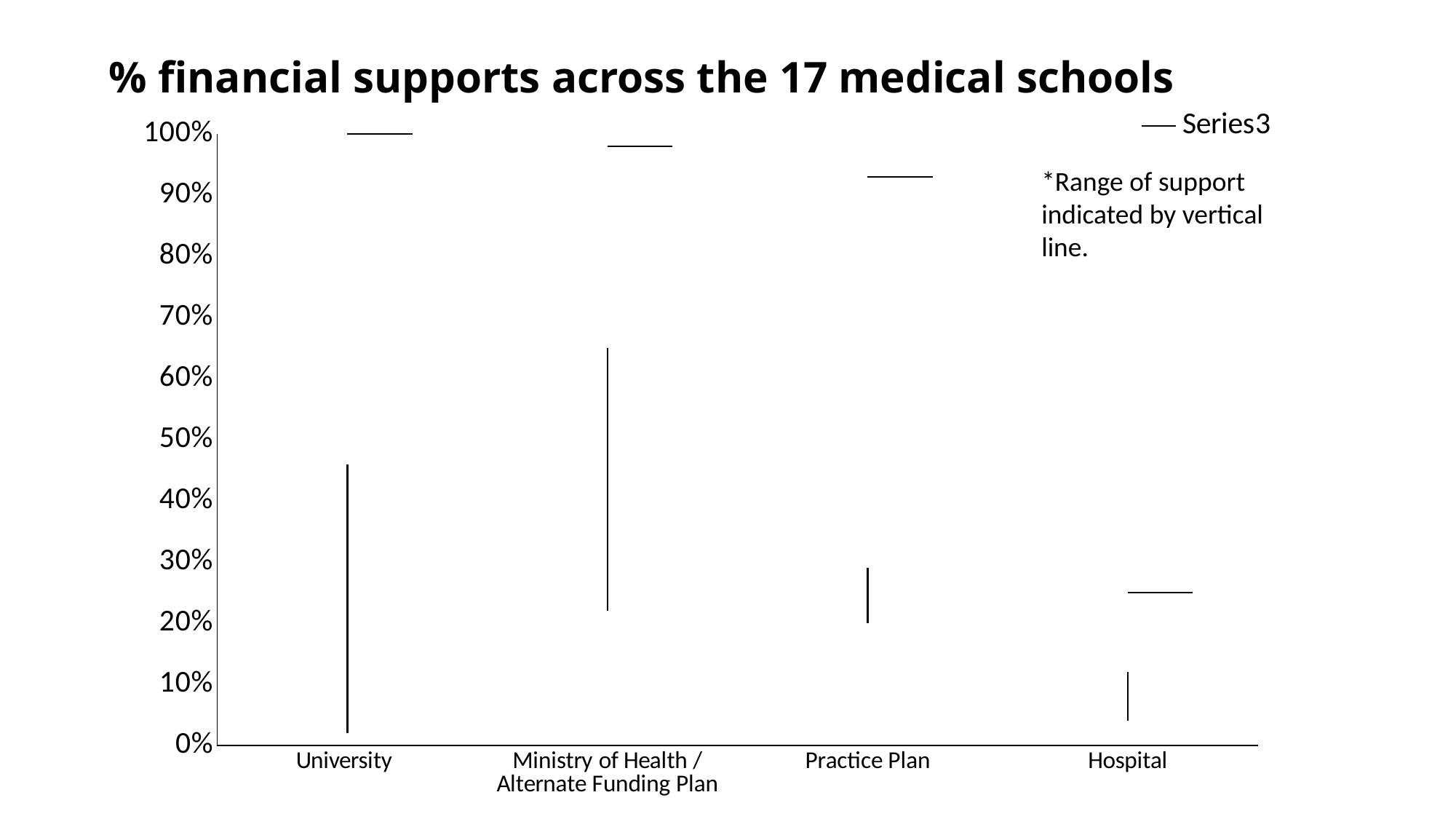
How many series does the legend list? 1 What is the title of the chart? % financial supports across the 17 medical schools Is the top of the vertical range line for Hospital greater or less than 20%? less Is the top of the vertical range line for Ministry of Health / Alternate Funding Plan greater or less than 60%? greater Which category has the highest top of its vertical range line? Ministry of Health / Alternate Funding Plan Is the bottom of the vertical range line for University greater or less than 10%? less What is the name of the series shown in the legend? Series3 How many categories are shown on the x axis? 4 Which has a higher top of its vertical range line, University or Practice Plan? University